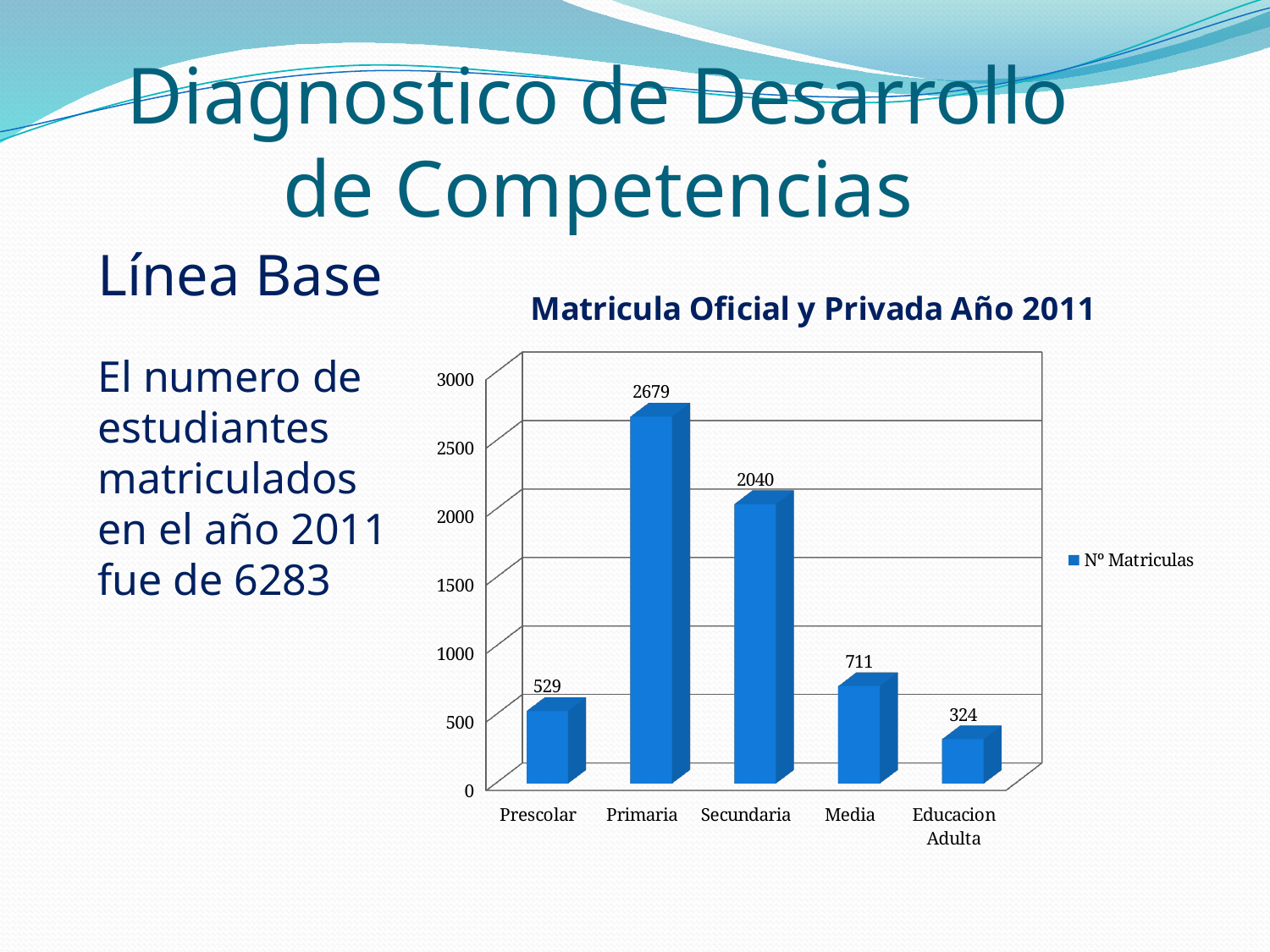
What is the value for Educacion Adulta? 324 What is the difference between the values for Media and Prescolar? 182 What is the value for Media? 711 How many categories are shown on the x axis? 5 Which category has the lowest value? Educacion Adulta What is the value for Primaria? 2679 Is the value for Secundaria greater or less than 2500? less Which category has the highest value? Primaria What kind of chart is shown? bar chart Which is larger, the value for Prescolar or the value for Media? Media What is the title of the chart? Matricula Oficial y Privada Año 2011 What is the difference between the values for Primaria and Secundaria? 639